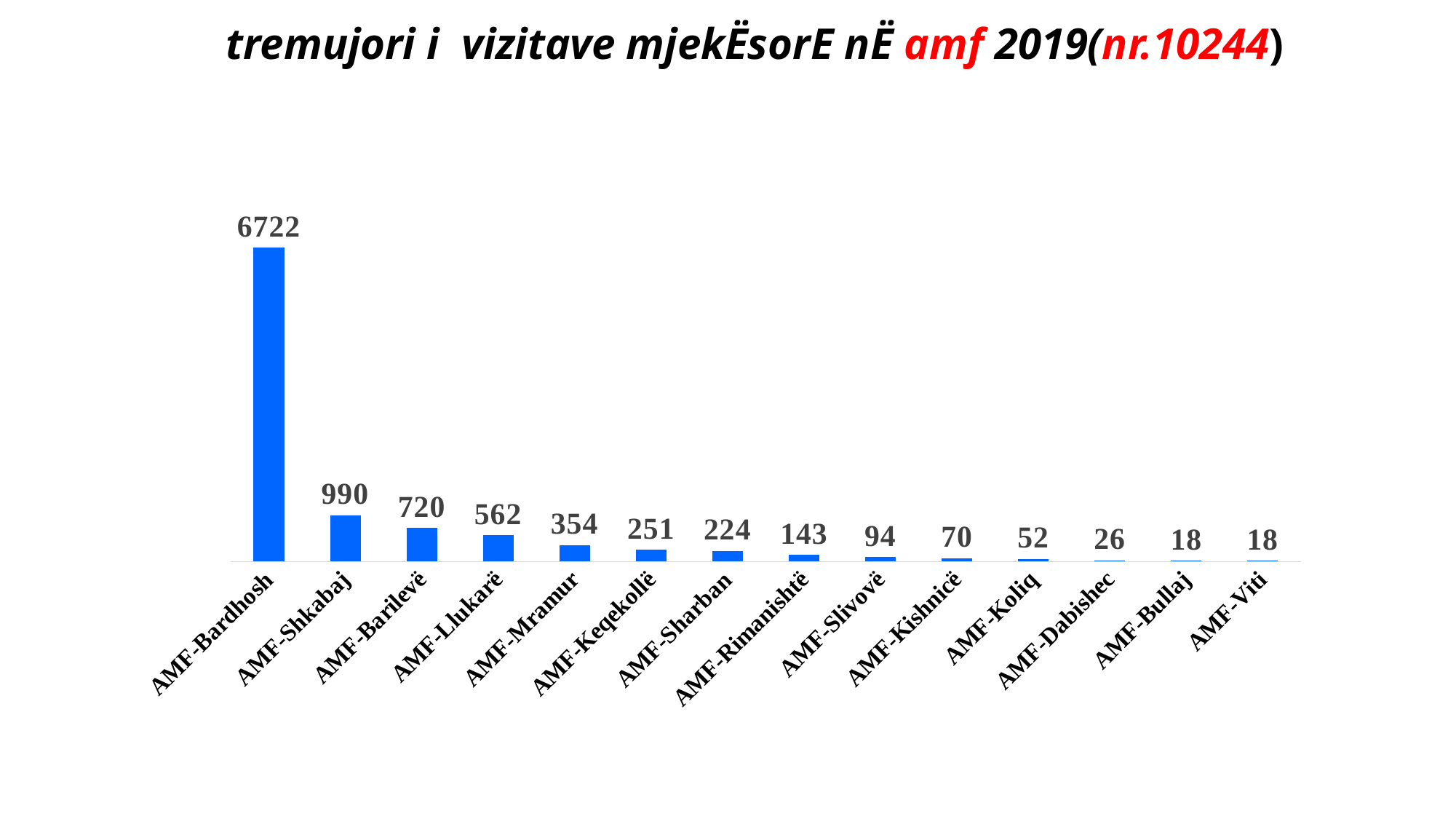
What is the value for AMF-Mramur? 354 What kind of chart is shown on the slide? Bar chart What number is shown in parentheses in the chart title? nr.10244 What is the value for AMF-Bardhosh? 6722 What is the value for AMF-Shkabaj? 990 Which category has the highest value? AMF-Bardhosh Do the values rise or fall from left to right along the x axis? Fall What is the difference between the values for AMF-Bardhosh and AMF-Shkabaj? 5732 What is the value for AMF-Rimanishtë? 143 Which is larger, the value for AMF-Keqekollë or the value for AMF-Sharban? AMF-Keqekollë What is the difference between the values for AMF-Barilevë and AMF-Llukarë? 158 How many categories are shown on the x axis? 14